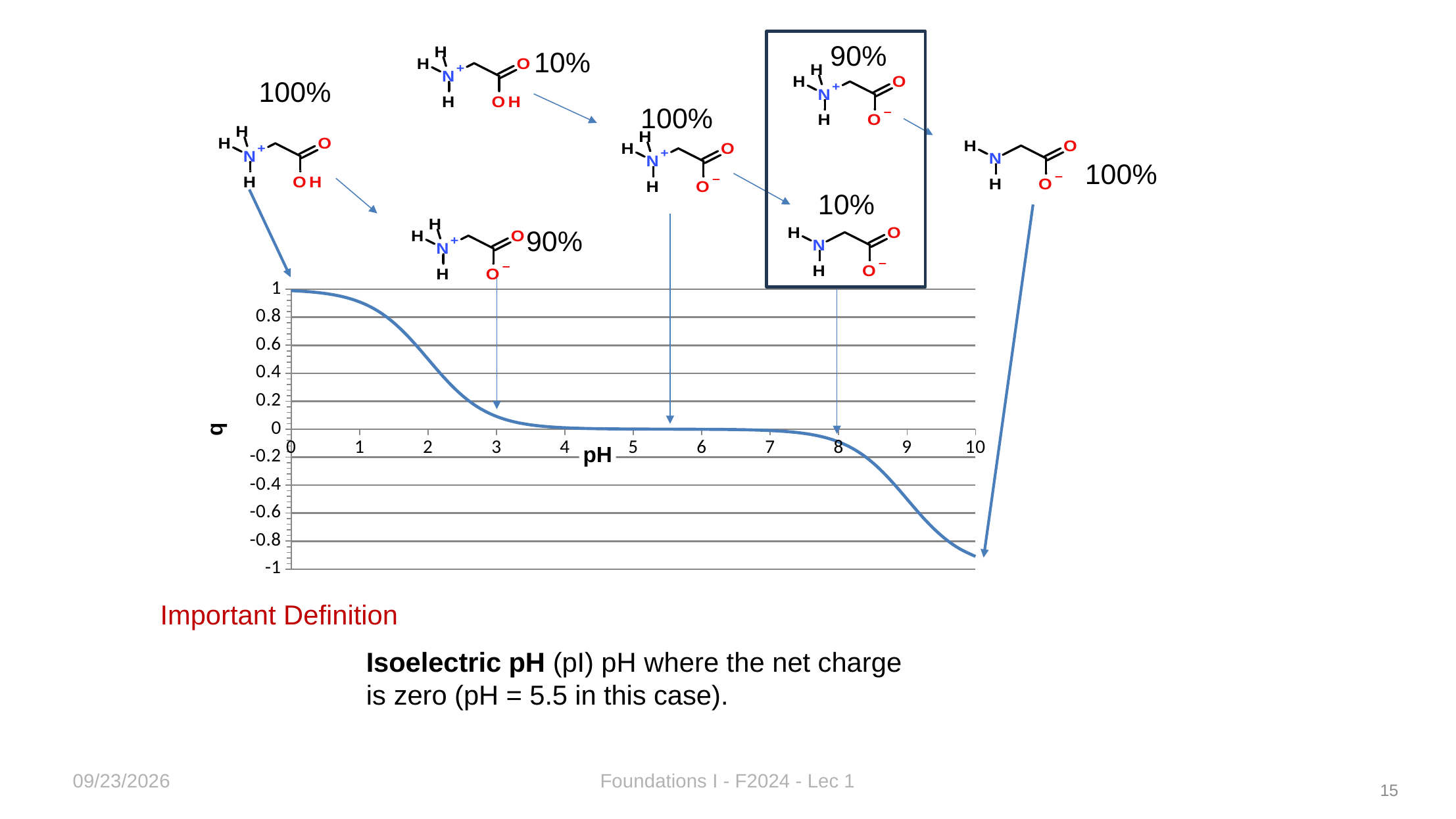
Is the value of q at pH 2 greater or less than 0.4? greater Is the value of q at pH 3 greater or less than 0.4? less At which pH on the x axis is q highest? 0 Which is larger, q at pH 2 or q at pH 8? pH 2 What is the label of the x axis of the chart? pH Does the net charge q rise or fall as pH increases along the x axis? fall At which pH on the x axis is q lowest? 10 What is the label of the y axis of the chart? q What kind of chart is shown on the slide? line chart Is the value of q at pH 9 greater or less than -0.2? less